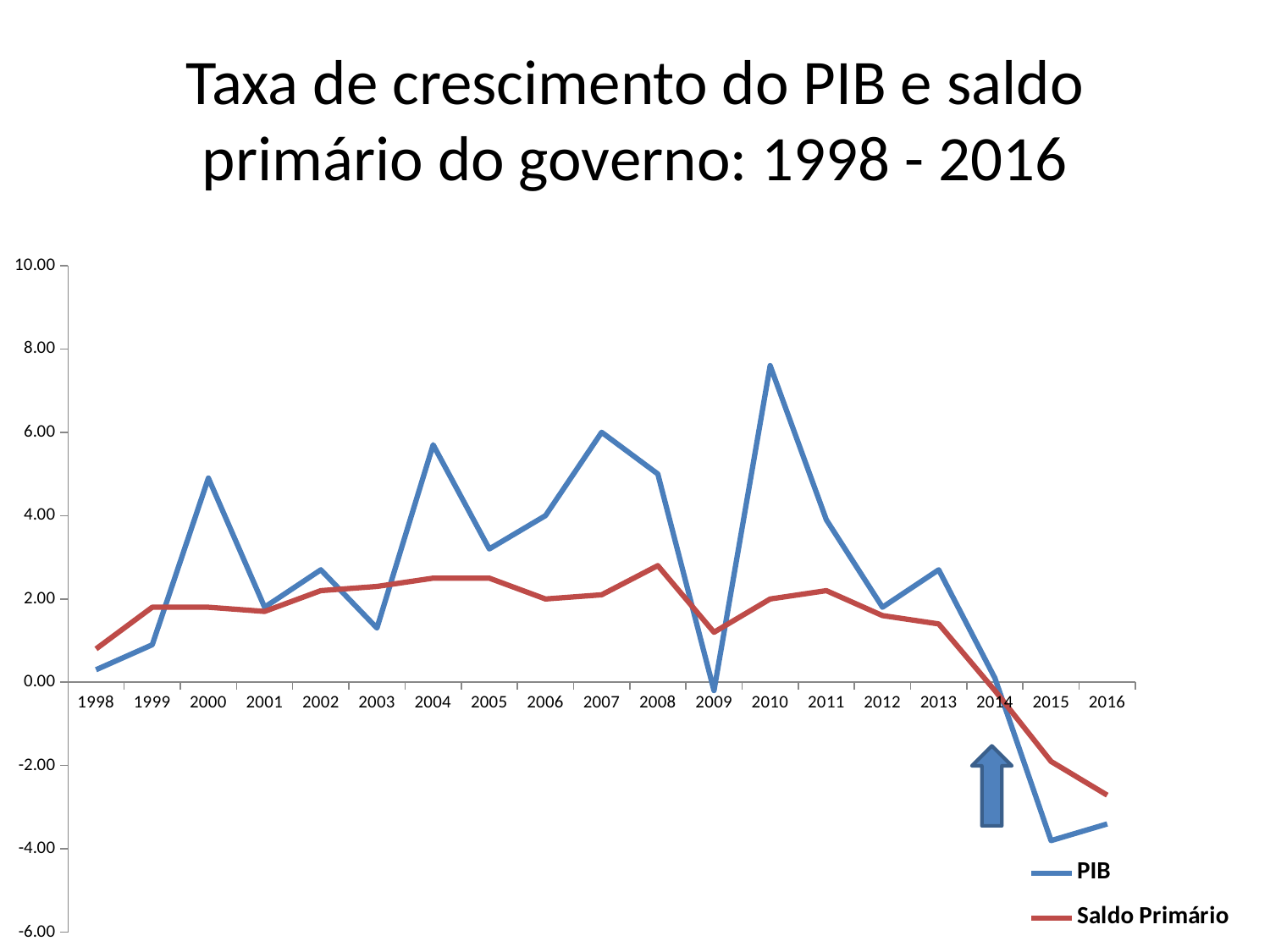
Does the PIB series rise or fall from 2013 to 2015? fall Is the PIB value for 2015 greater or less than -2.00? less In which year does the PIB series reach its lowest value? 2015 Is the Saldo Primário value for 2016 greater or less than -2.00? less How many years are plotted along the x axis? 19 In 2015, which series has the larger value, PIB or Saldo Primário? Saldo Primário What kind of chart is shown on the slide? line chart In which year does the PIB series reach its highest value? 2010 In which year does the Saldo Primário series reach its lowest value? 2016 How many series does the legend list? 2 Is the PIB value for 2010 greater or less than 6.00? greater What are the two series named in the legend? PIB and Saldo Primário